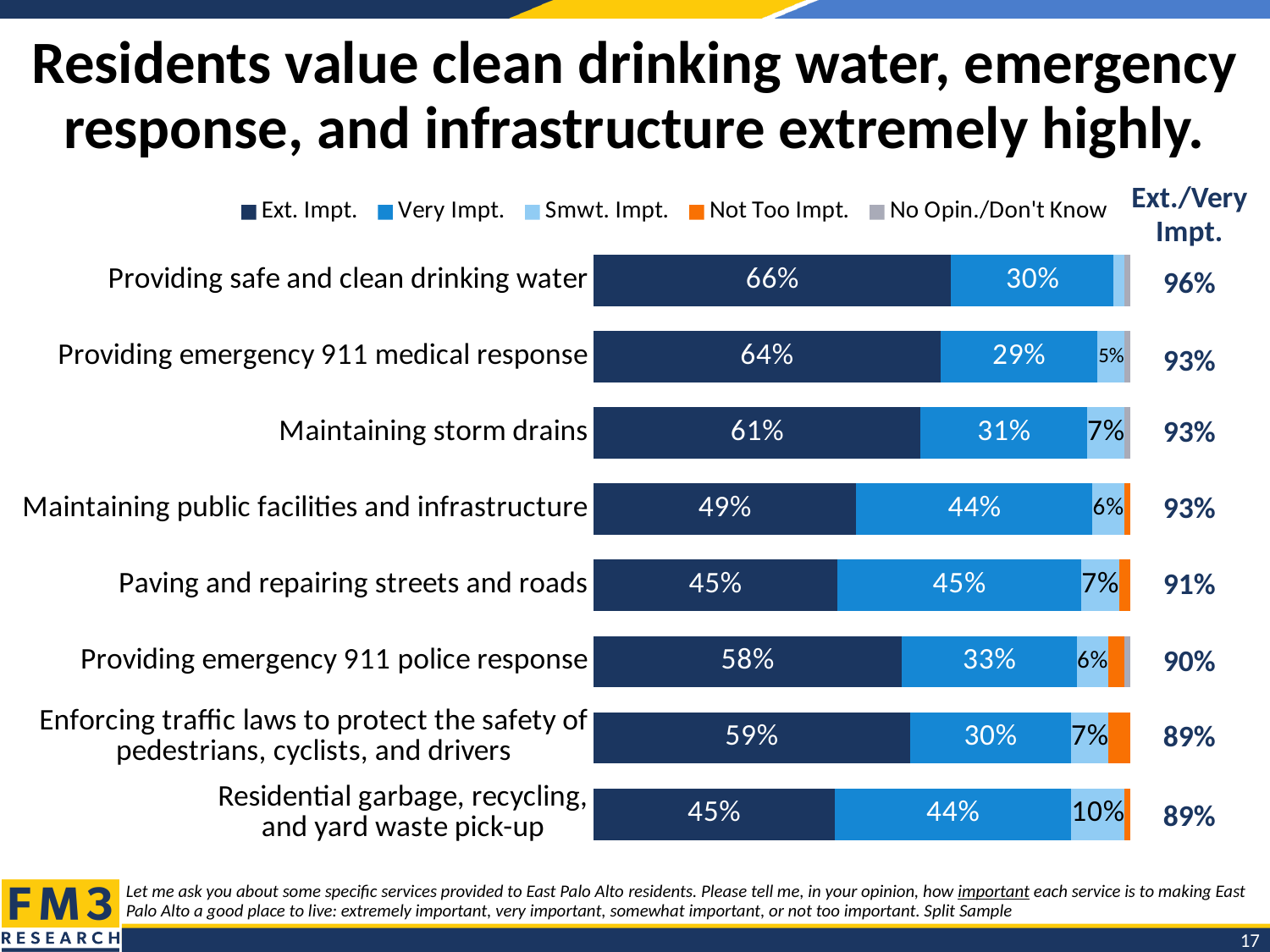
What colour represents Not Too Impt. in the legend? Orange What is the Smwt. Impt. value for residential garbage, recycling, and yard waste pick-up? 10% What percentage of residents rated providing safe and clean drinking water as extremely important (Ext. Impt.)? 66% What is the Very Impt. value for paving and repairing streets and roads? 45% What is the difference in Ext. Impt. percentage between providing safe and clean drinking water and providing emergency 911 medical response? 2 percentage points How many series does the legend list? 5 Which has a larger Ext. Impt. percentage: maintaining storm drains or providing emergency 911 police response? Maintaining storm drains How many services are listed in the chart? 8 What kind of chart is shown on the slide? Stacked bar chart Which service has the highest Ext./Very Impt. figure? Providing safe and clean drinking water What is the Ext./Very Impt. figure shown for providing emergency 911 police response? 90% Which service has the highest Ext. Impt. percentage? Providing safe and clean drinking water